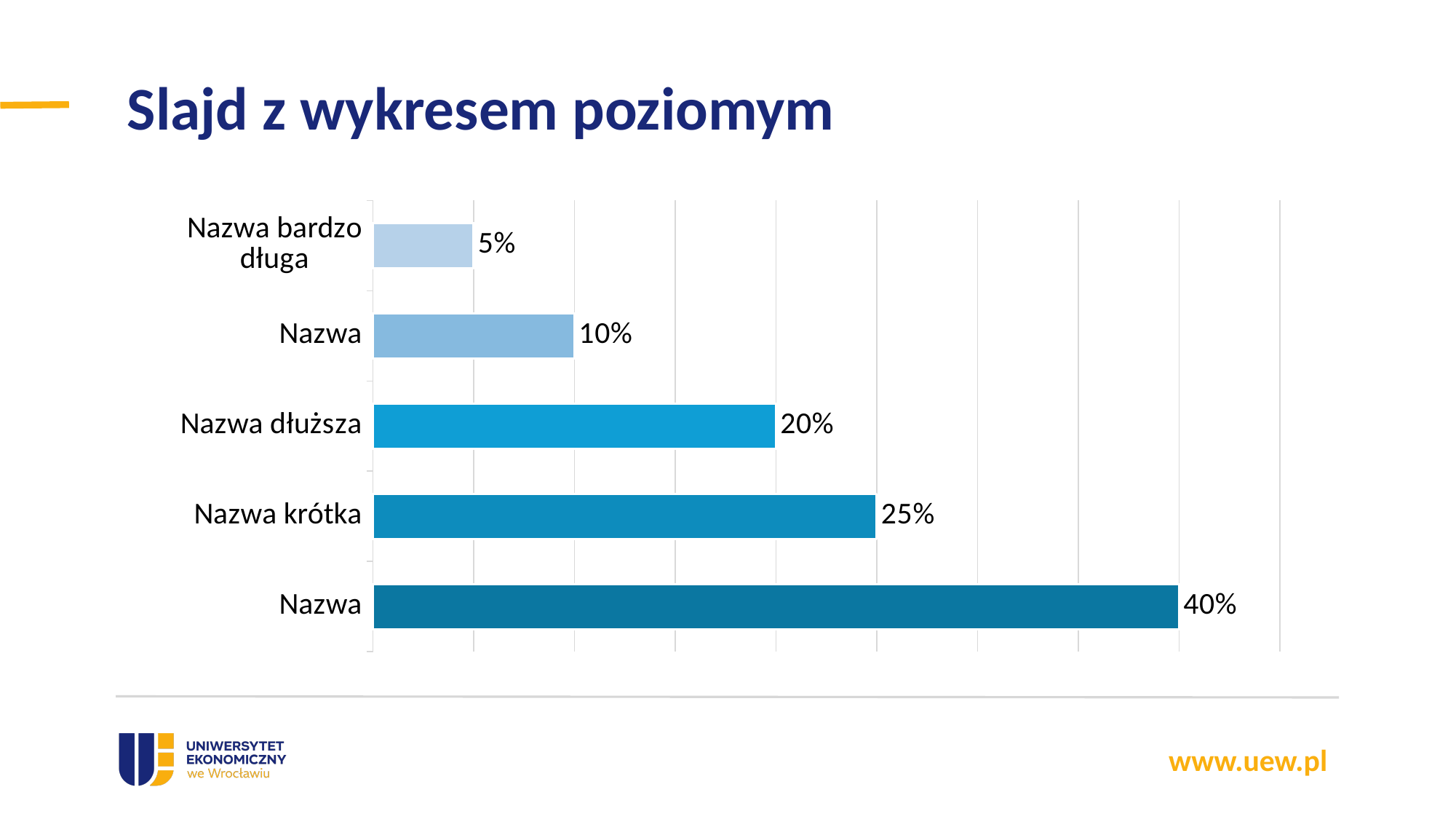
Which is larger, the value for "Nazwa dłuższa" or the value for "Nazwa bardzo długa"? Nazwa dłuższa What is the highest value shown in the chart? 40% What is the value for "Nazwa krótka"? 25% What kind of chart is shown on the slide? Bar chart How many bars does the chart have? 5 What is the value for "Nazwa dłuższa"? 20% What is the value of the second bar from the top, labelled "Nazwa"? 10% Which category has the lowest value? Nazwa bardzo długa What is the value of the bottom bar, labelled "Nazwa"? 40% What is the difference between the values for "Nazwa krótka" and "Nazwa dłuższa"? 5% What is the title of the slide? Slajd z wykresem poziomym What is the value for "Nazwa bardzo długa"? 5%